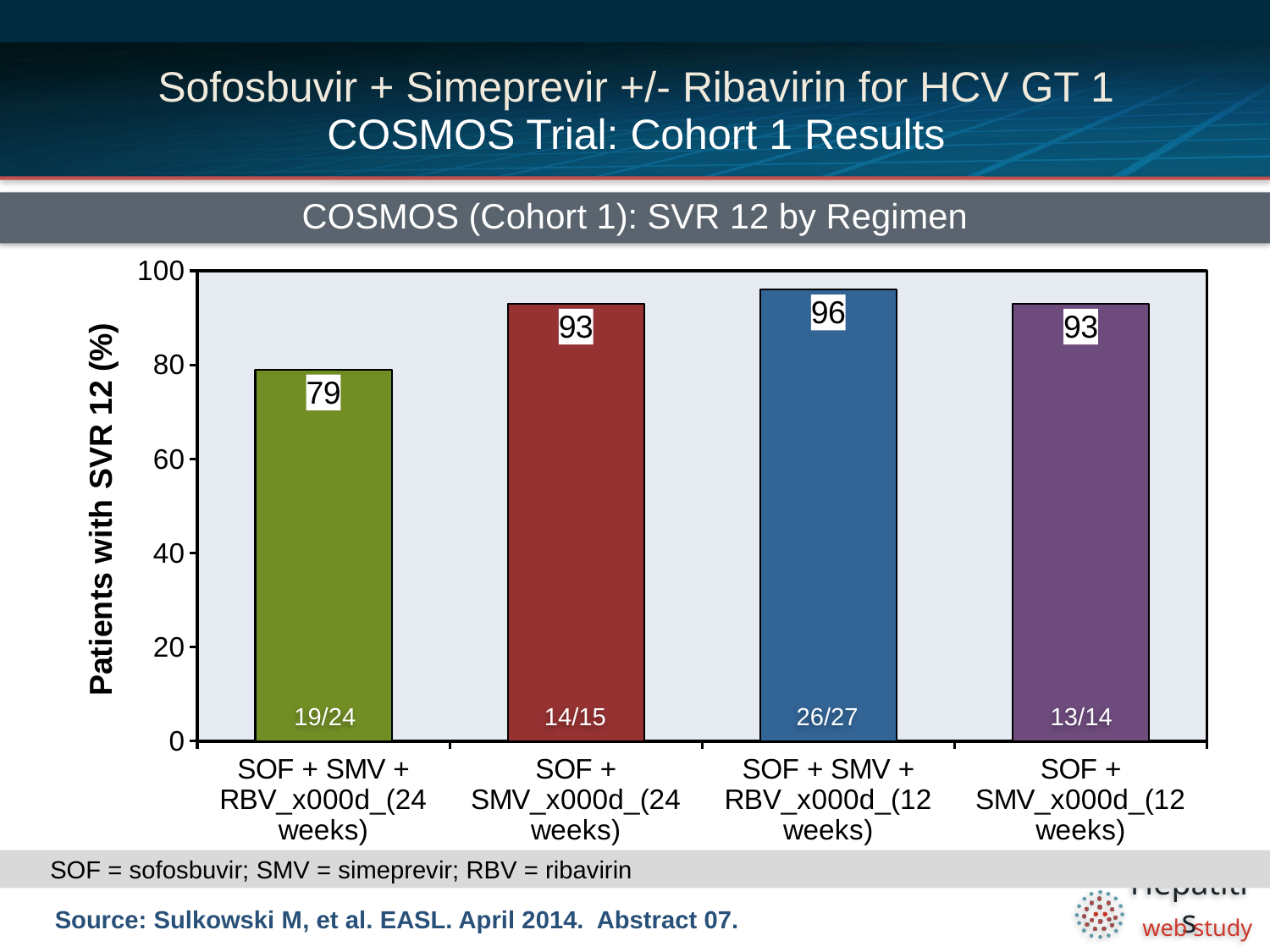
Which regimen has the highest SVR 12 rate? SOF + SMV + RBV (12 weeks) What fraction of patients is shown inside the bar for SOF + SMV (12 weeks)? 13/14 What type of chart is shown on the slide? Bar chart What is the SVR 12 rate for SOF + SMV + RBV (24 weeks)? 79 What is the difference in SVR 12 rate between SOF + SMV + RBV (12 weeks) and SOF + SMV + RBV (24 weeks)? 17 How many regimens are shown in the chart? 4 What is the title of the chart? COSMOS (Cohort 1): SVR 12 by Regimen Which regimen has the lowest SVR 12 rate? SOF + SMV + RBV (24 weeks) What fraction of patients is shown inside the bar for SOF + SMV + RBV (12 weeks)? 26/27 What is the SVR 12 rate for SOF + SMV + RBV (12 weeks)? 96 Which has a higher SVR 12 rate: SOF + SMV (24 weeks) or SOF + SMV + RBV (24 weeks)? SOF + SMV (24 weeks) What is the SVR 12 rate for SOF + SMV (24 weeks)? 93